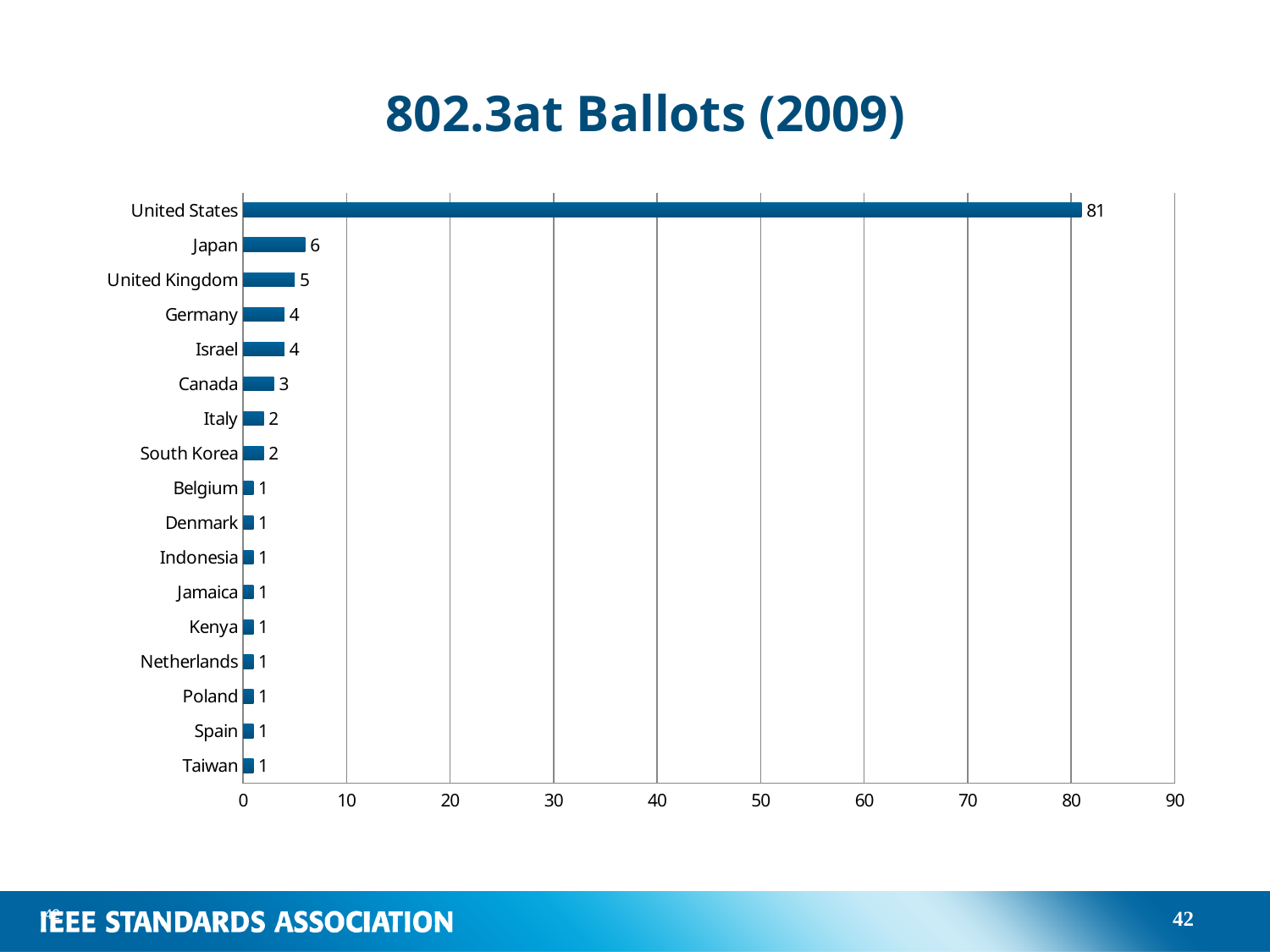
How many countries are shown in the chart? 17 Which country has the highest value? United States What is the difference between the values for United States and Japan? 75 What is the value for United Kingdom? 5 What is the value for Canada? 3 Which is larger, the value for United Kingdom or the value for Canada? United Kingdom What is the value for Japan? 6 Is the value for United States greater or less than 80? greater What is the title of the chart? 802.3at Ballots (2009) What is the value for United States? 81 What kind of chart is shown on the slide? bar chart What is the difference between the values for Japan and Germany? 2